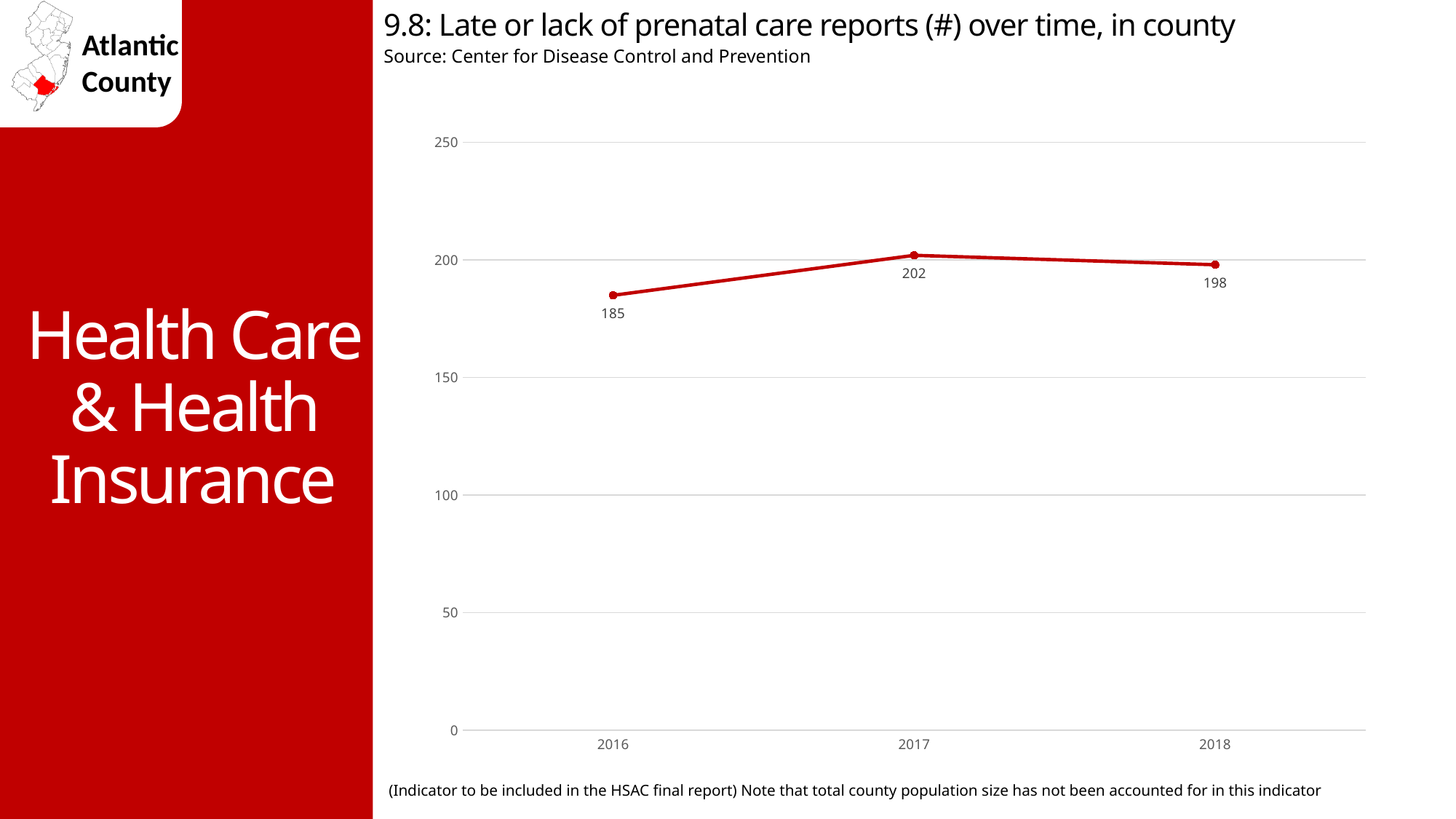
What is the number of late or lack of prenatal care reports in 2017? 202 What is the difference between the 2017 and 2016 values? 17 What is the source of the data shown in the chart? Center for Disease Control and Prevention What is the number of late or lack of prenatal care reports in 2018? 198 Is the value for 2016 greater or less than 200? less Which year has a larger value, 2016 or 2018? 2018 Which year has the lowest number of late or lack of prenatal care reports? 2016 How many years are plotted on the chart? 3 What kind of chart is shown on the slide? line chart What is the difference between the 2017 and 2018 values? 4 Which year has the highest number of late or lack of prenatal care reports? 2017 What is the number of late or lack of prenatal care reports in 2016? 185